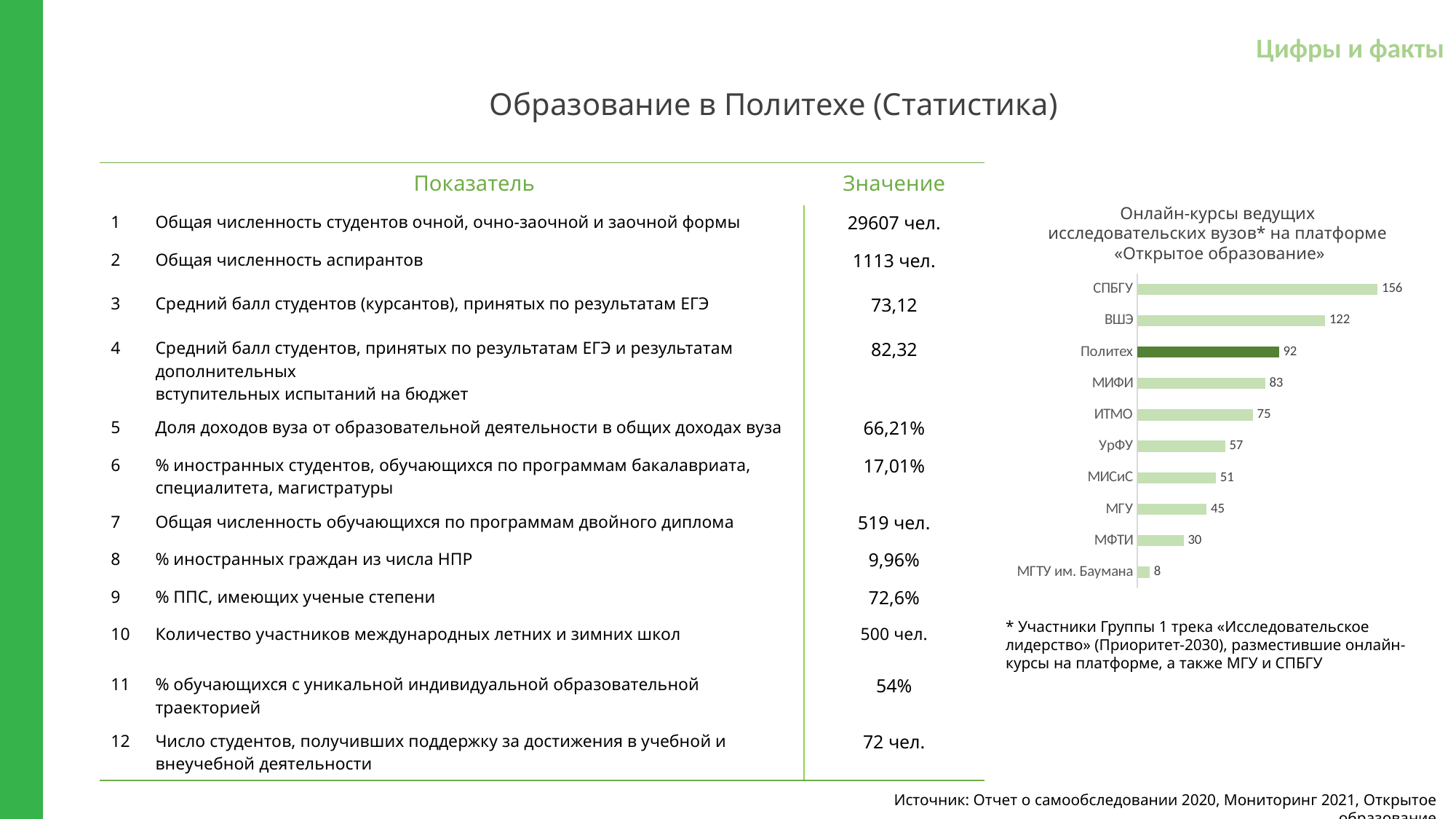
What is the difference between the values for УрФУ and МИСиС in the chart? 6 What type of chart is used to show the online courses data? Bar chart Which university has the highest number of online courses in the chart? СПБГУ What is the value shown for ВШЭ in the chart? 122 Which has more online courses in the chart, МИФИ or ИТМО? МИФИ What is the difference between the values for СПБГУ and Политех in the chart? 64 How many online courses does Политех have on the «Открытое образование» platform according to the chart? 92 How many universities are shown in the chart? 10 What is the value shown for МФТИ in the chart? 30 What is the title of the chart on the slide? Онлайн-курсы ведущих исследовательских вузов* на платформе «Открытое образование» Which bar in the chart is highlighted in a darker green colour? Политех Which university has the lowest number of online courses in the chart? МГТУ им. Баумана